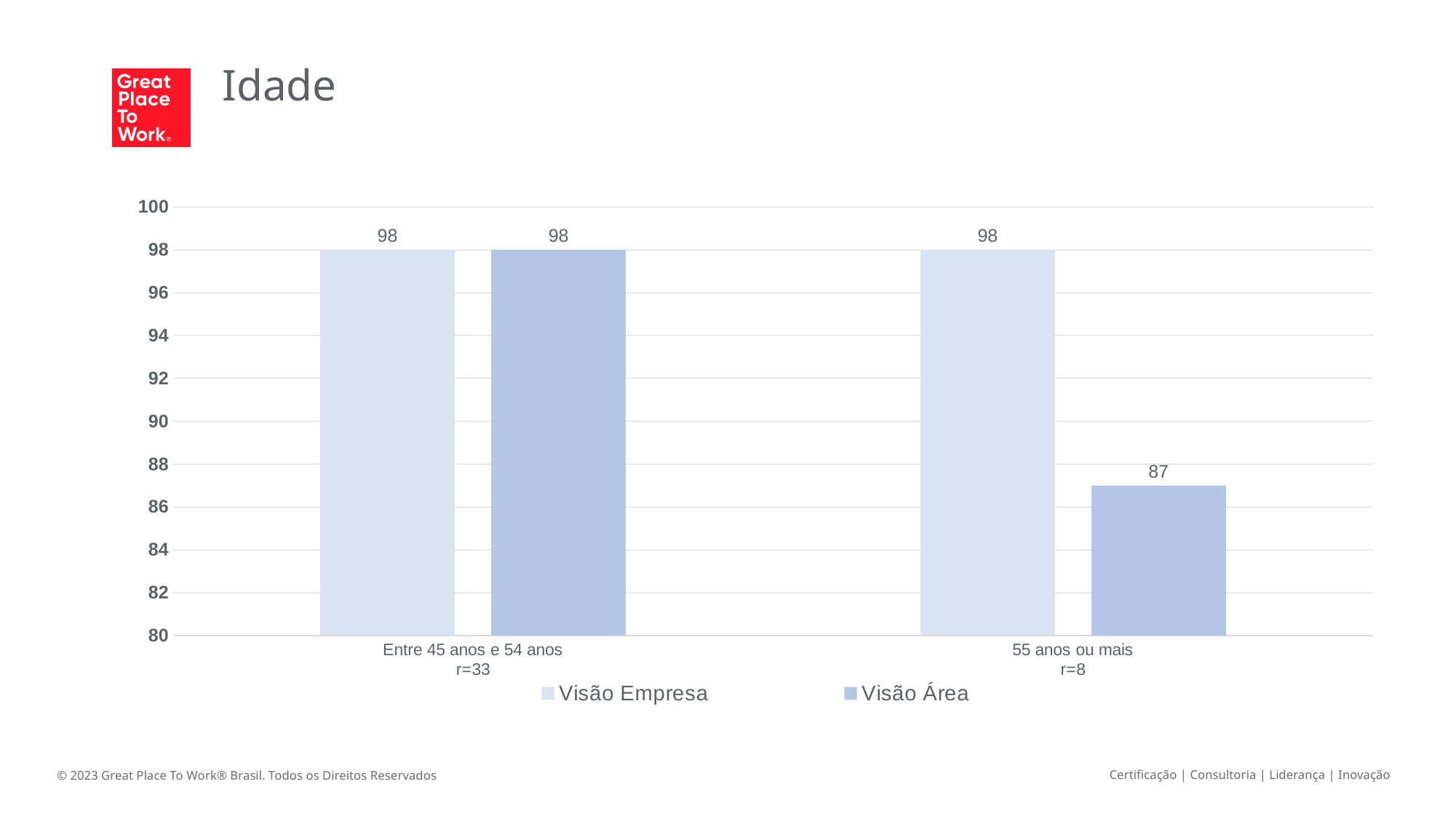
What is the Visão Empresa value for the 'Entre 45 anos e 54 anos' category? 98 What is the Visão Área value for the '55 anos ou mais' category? 87 What is the title of the slide containing the chart? Idade For '55 anos ou mais', which is larger: Visão Empresa or Visão Área? Visão Empresa Which category has the lowest Visão Área value? 55 anos ou mais What is the Visão Área value for the 'Entre 45 anos e 54 anos' category? 98 What is the difference between the Visão Empresa and Visão Área values for '55 anos ou mais'? 11 What kind of chart is shown on the slide? bar chart How many age categories are shown on the x axis? 2 What is the Visão Empresa value for the '55 anos ou mais' category? 98 Is the Visão Área value for '55 anos ou mais' greater or less than 90? less How many series does the legend list? 2